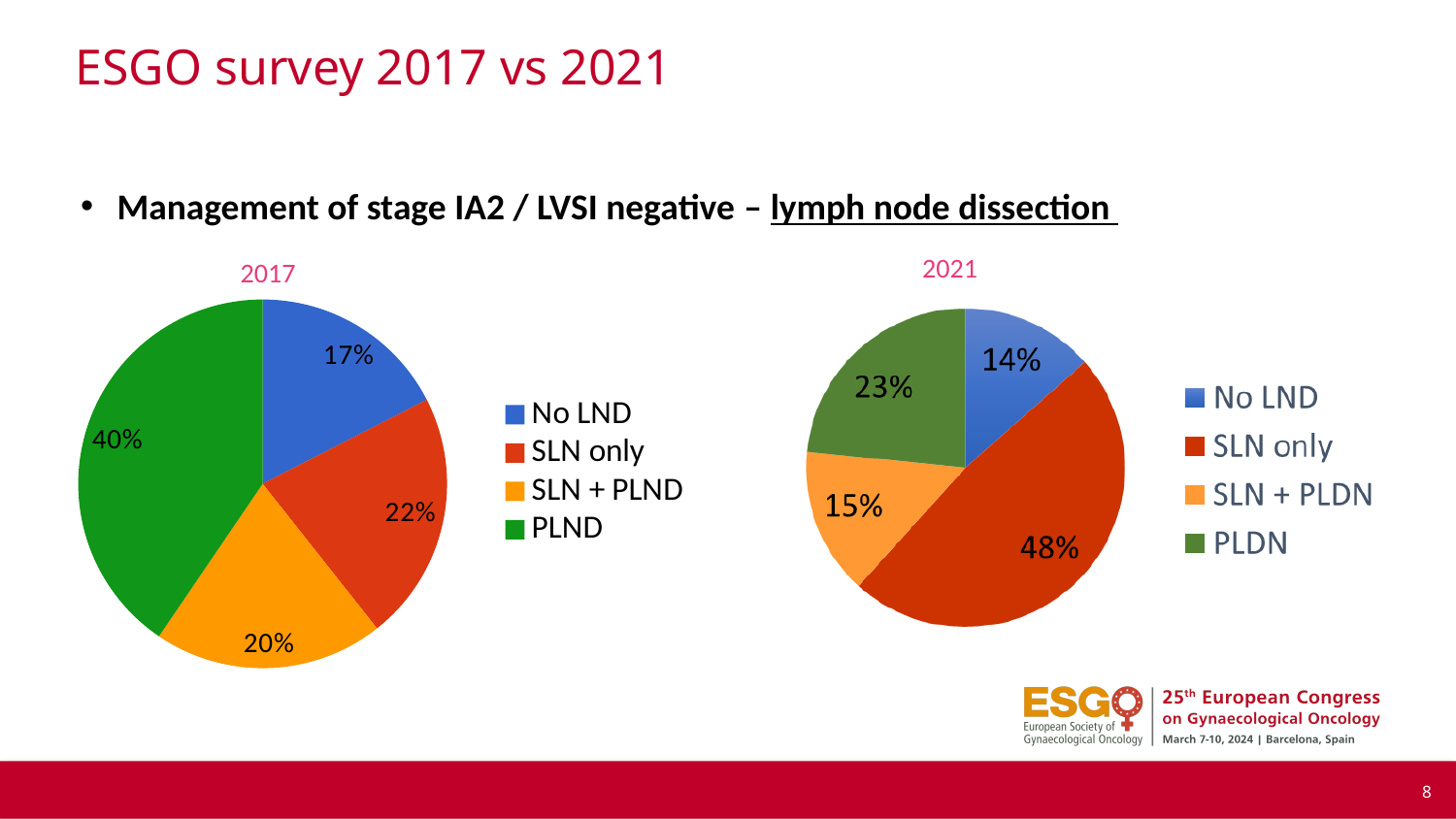
What type of chart is used for the 2017 data? Pie chart In the 2021 pie chart, what share is labelled for SLN + PLDN? 15% In the 2017 pie chart, which category has the largest slice? PLND How many categories does the 2021 pie chart show? 4 In the 2021 pie chart, which category has the largest slice? SLN only In the 2017 pie chart, what share is labelled for No LND? 17% What is the difference between the SLN only share in 2021 and the SLN only share in 2017? 26% In the 2017 pie chart, what share is labelled for PLND? 40% In the 2021 pie chart, what colour is the PLDN slice? Green In the 2021 pie chart, what share is labelled for SLN only? 48% In the 2021 pie chart, which category has the smallest slice? No LND In the 2017 pie chart, which is larger: the SLN only slice or the SLN + PLND slice? SLN only